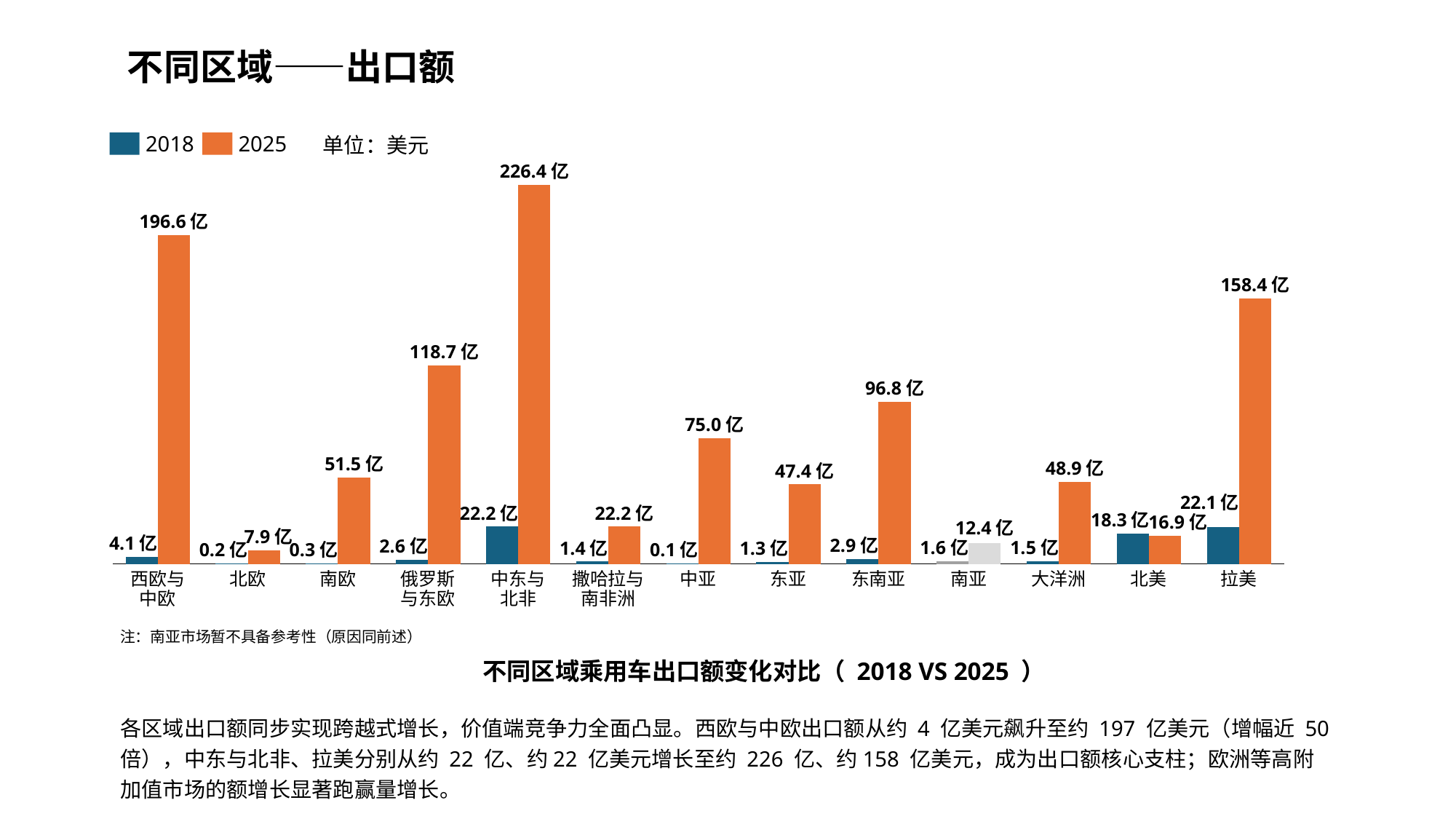
2025年，俄罗斯与东欧和东南亚哪个区域的出口额更高？ 俄罗斯与东欧 北美2018年和2025年的出口额哪个更高？ 2018 图中西欧与中欧2018年的出口额是多少？ 4.1 亿 2025年出口额最高的区域是哪个？ 中东与北非 图中北美2025年的出口额是多少？ 16.9 亿 2018年出口额最高的区域是哪个？ 中东与北非 拉美2025年出口额与2018年出口额相差多少？ 136.3 亿 2025年出口额最低的区域是哪个？ 北欧 这是什么类型的图表？ 柱状图（条形图） 图中共有多少个区域？ 13 图例中列出了几个系列？ 2 图中中东与北非2025年的出口额是多少？ 226.4 亿